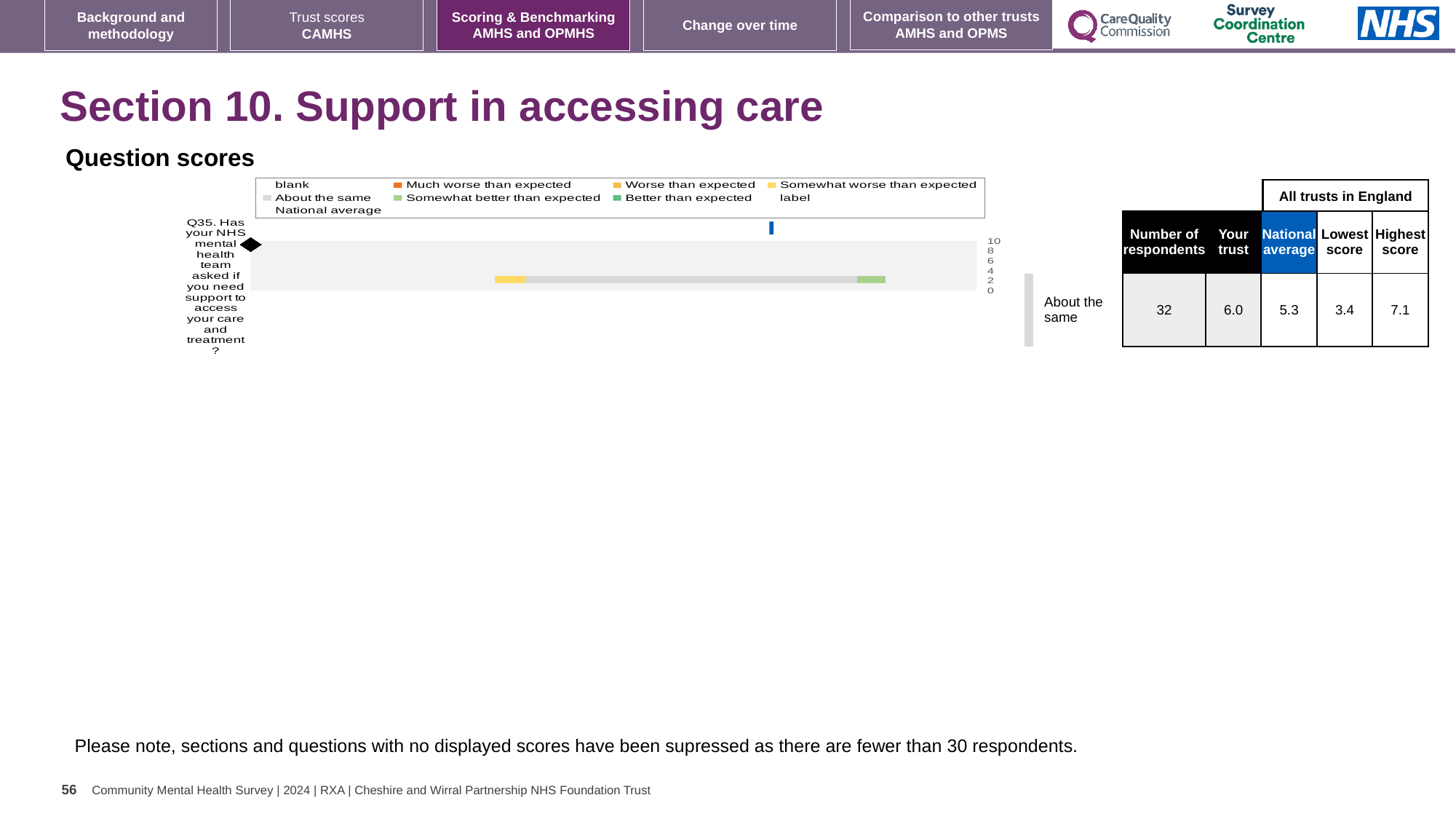
What is the highest score among all trusts in England for Q35? 7.1 What is the 'Your trust' score for Q35? 6.0 What kind of chart is used to show the Q35 question score? bar chart What is the lowest score among all trusts in England for Q35? 3.4 Which question is shown in the Question scores chart? Q35. Has your NHS mental health team asked if you need support to access your care and treatment? What is the national average score for Q35? 5.3 What is the difference between the highest and lowest scores for Q35 across all trusts in England? 3.7 How many questions are plotted in the Question scores chart? 1 Which benchmark category does the trust's Q35 score fall into? About the same How many respondents answered Q35? 32 Which is larger for Q35, the trust's score or the national average? Your trust